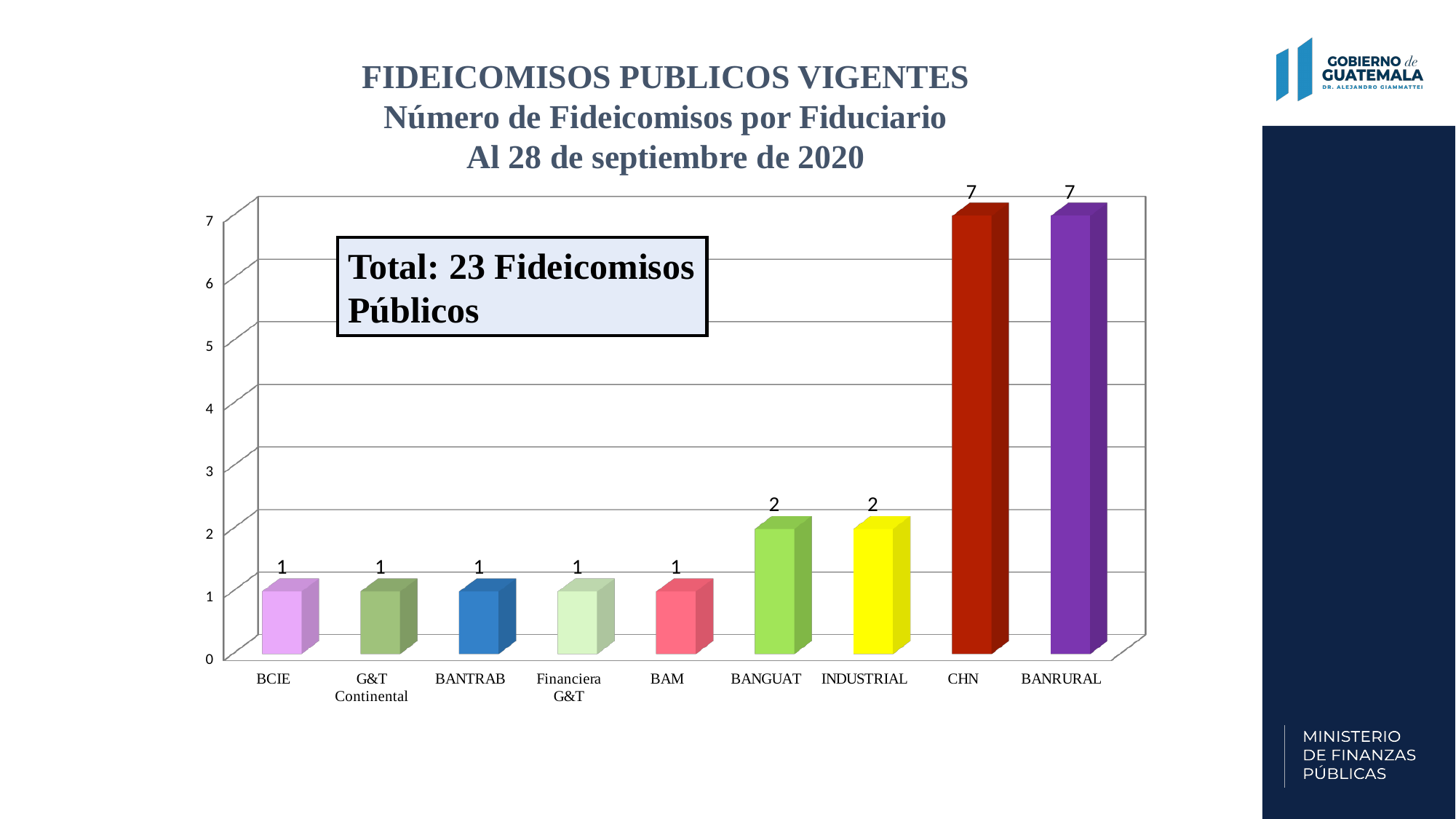
What kind of chart is shown on the slide? bar chart Which is larger, the value for INDUSTRIAL or the value for BAM? INDUSTRIAL What total number of public trusts does the text box on the chart state? 23 Do the values generally rise or fall from left to right along the x axis? rise What is the difference between the values for CHN and BANTRAB? 6 What is the value for CHN? 7 What is the difference between the values for BANRURAL and BANGUAT? 5 How many categories are shown on the x axis? 9 What is the value for BANGUAT? 2 What is the value for BCIE? 1 What date does the chart title say the data is as of? 28 de septiembre de 2020 What is the value for INDUSTRIAL? 2